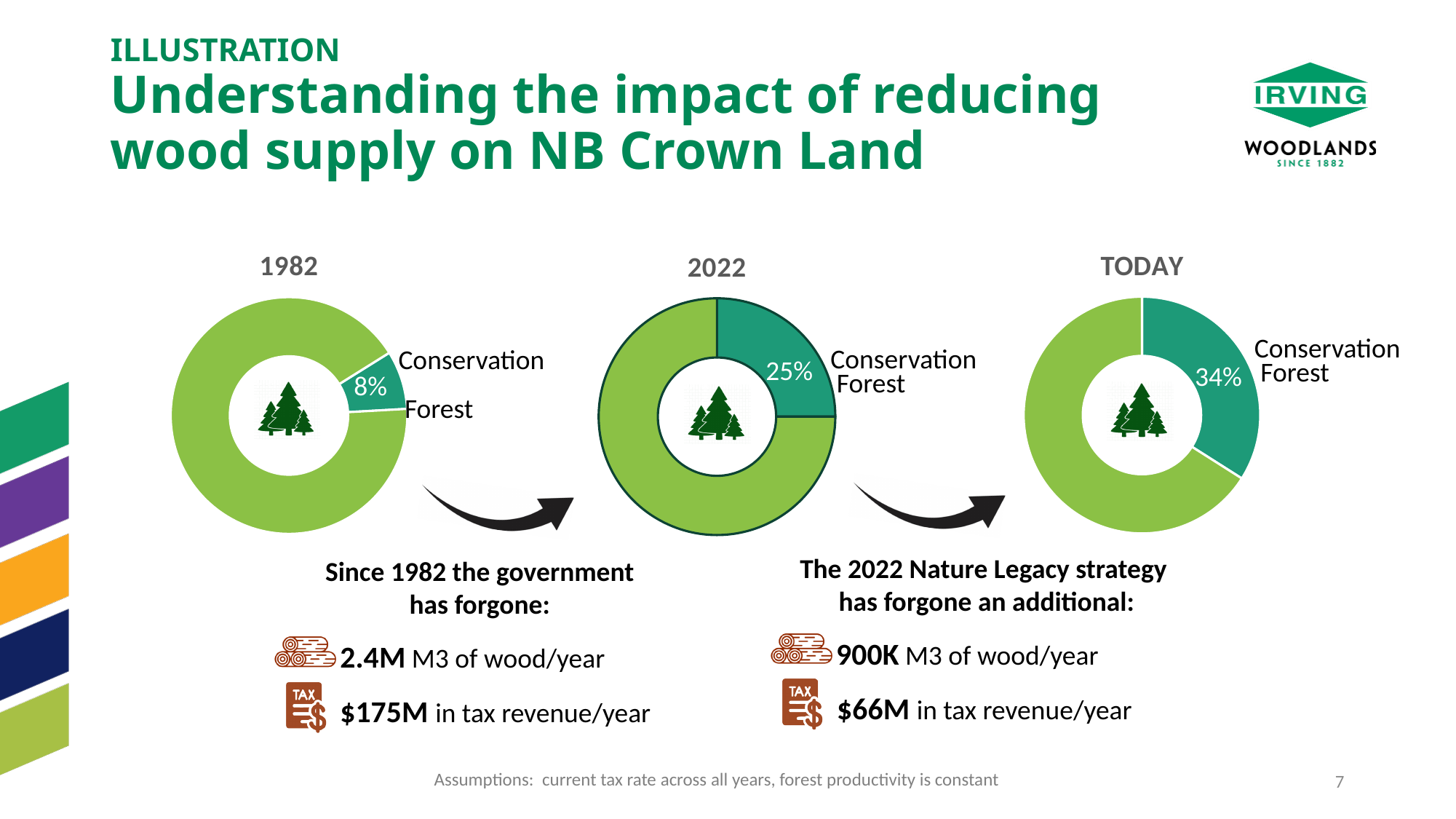
How many donut charts are shown on the slide? 3 Across the three charts from 1982 to TODAY, does the Conservation Forest share rise or fall? Rise By how many percentage points is the Conservation Forest share in the TODAY chart higher than in the 1982 chart? 26 percentage points By how many percentage points did the Conservation Forest share increase from the 2022 chart to the TODAY chart? 9 percentage points Is the Conservation Forest share larger in the 2022 chart or in the 1982 chart? 2022 In the TODAY chart, what percentage is labelled for Conservation Forest? 34% Which chart shows the largest Conservation Forest share: 1982, 2022 or TODAY? TODAY What kind of chart is used to show the Conservation Forest share for each year? Donut (pie) chart In the 1982 chart, what percentage is labelled for Conservation Forest? 8% Which chart shows the smallest Conservation Forest share: 1982, 2022 or TODAY? 1982 In the 2022 chart, what percentage is labelled for Conservation Forest? 25% By how many percentage points did the Conservation Forest share increase from the 1982 chart to the 2022 chart? 17 percentage points